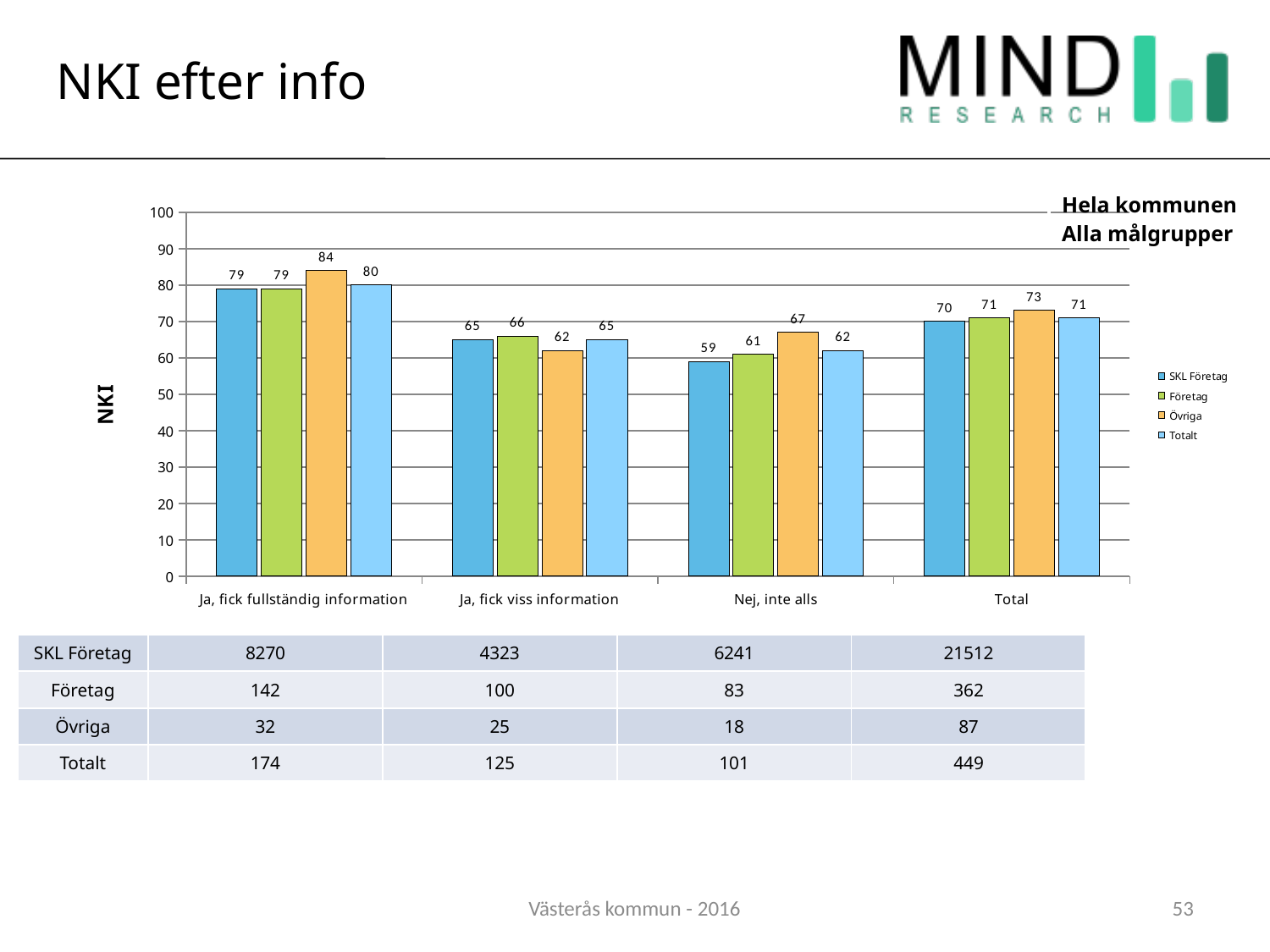
What is the difference between the Övriga value and the SKL Företag value in the 'Nej, inte alls' category? 8 What is the label of the y axis? NKI What kind of chart is shown on the slide? bar chart Which category has the highest NKI value for Företag? Ja, fick fullständig information Which is larger: the Totalt value for 'Ja, fick fullständig information' or the Totalt value for 'Ja, fick viss information'? Ja, fick fullständig information Which category has the lowest NKI value for Övriga? Ja, fick viss information Is the Företag value for 'Nej, inte alls' greater or less than 70? less What is the NKI value for Övriga in the 'Ja, fick fullständig information' category? 84 What is the NKI value for Totalt in the 'Total' category? 71 How many series does the legend list? 4 How many categories are shown on the x axis of the chart? 4 What is the NKI value for SKL Företag in the 'Nej, inte alls' category? 59